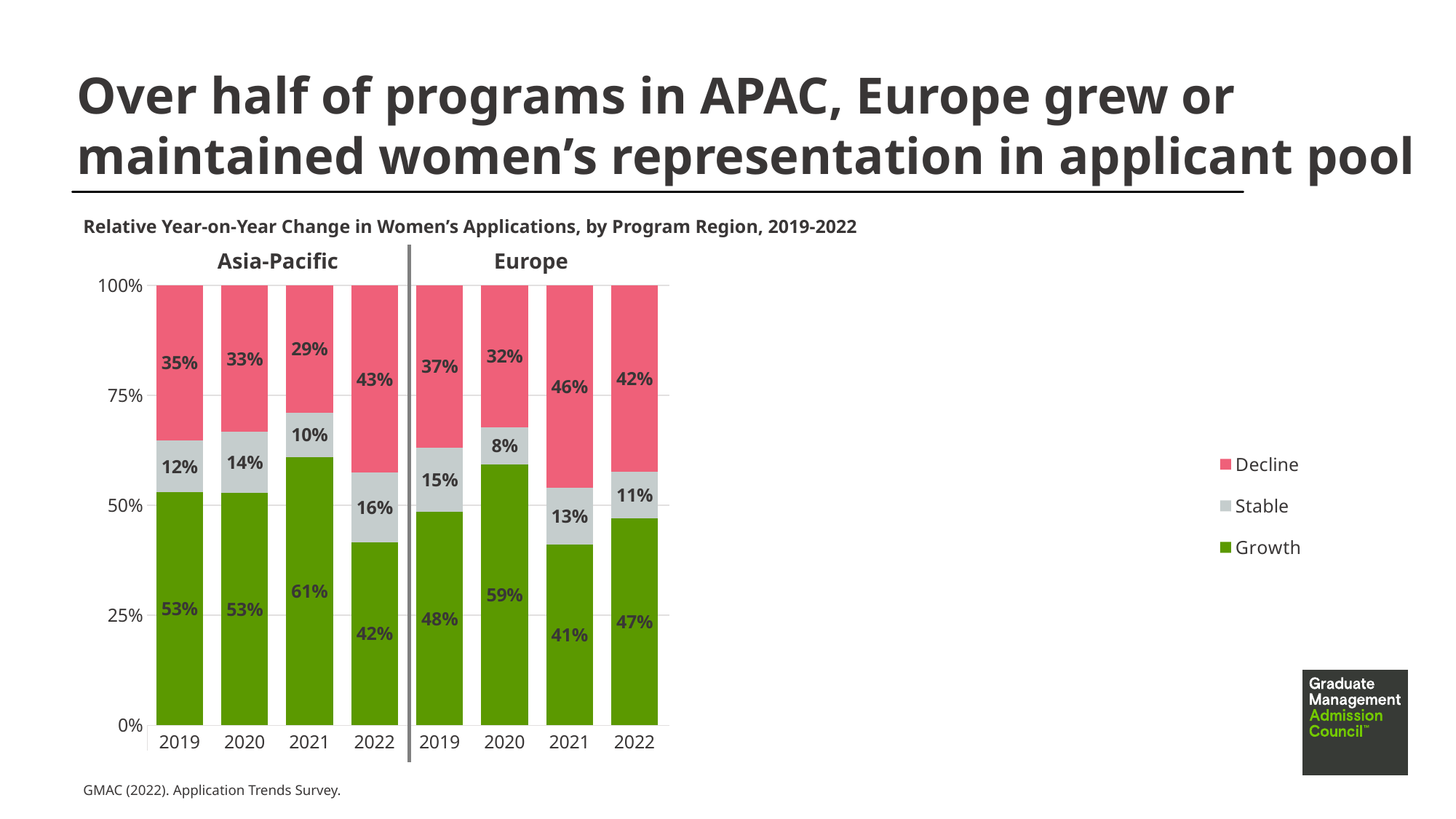
How many bars are plotted in the chart? 8 How many series does the legend list? 3 What is the Decline share for Asia-Pacific in 2022? 43% What is the difference between the Growth share for Europe in 2020 and Europe in 2021? 18 percentage points What is the Growth share for Asia-Pacific in 2021? 61% Which is larger: the Decline share for Asia-Pacific in 2019 or for Europe in 2019? Europe in 2019 What kind of chart is shown on the slide? Stacked bar chart Which Europe year has the lowest Growth share? 2021 Which colour represents the Stable series in the chart? Grey What is the Decline share for Europe in 2021? 46% What is the Stable share for Europe in 2020? 8% Which Asia-Pacific year has the highest Growth share? 2021